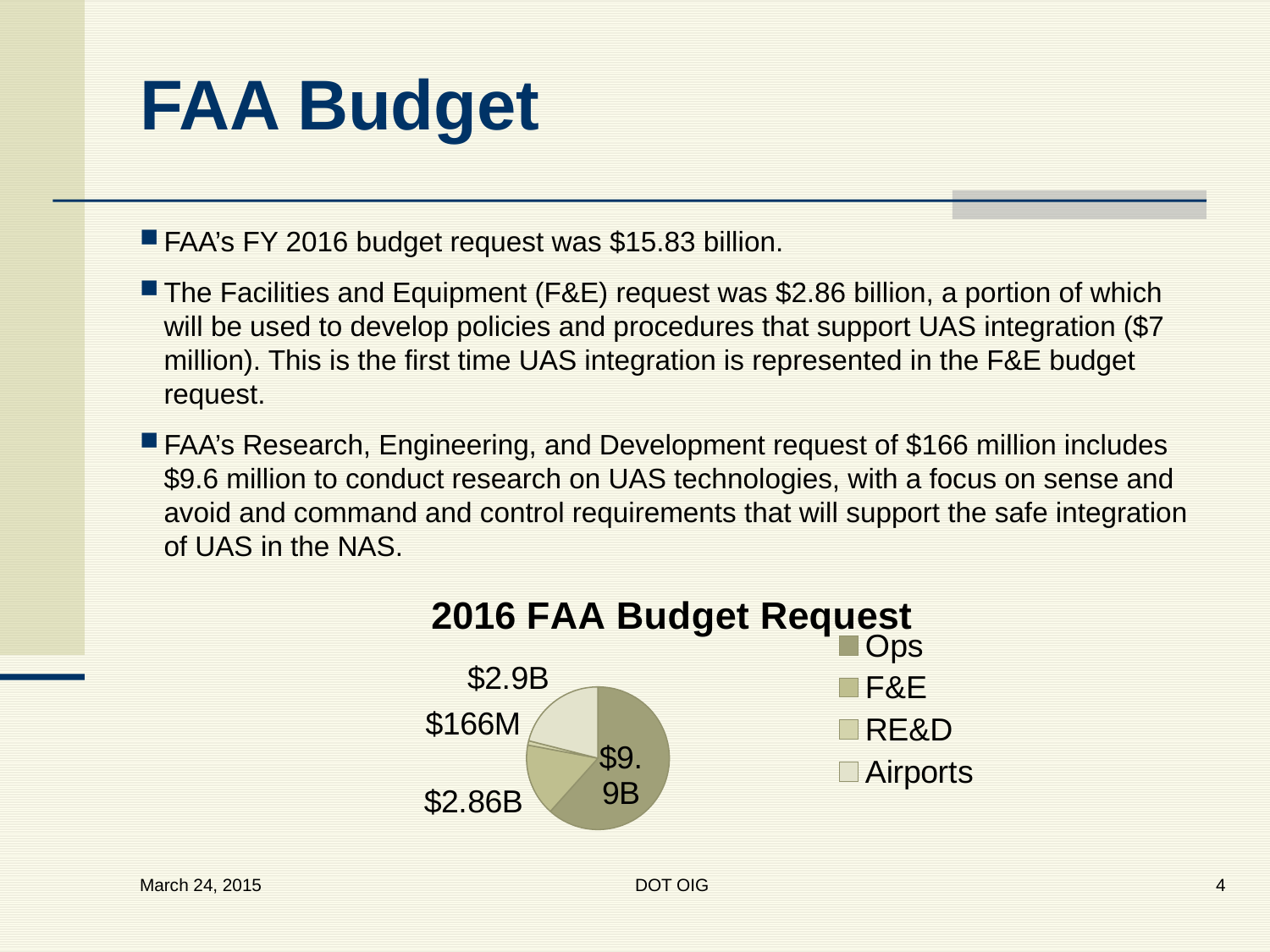
Which is larger in the pie chart, Ops or F&E? Ops What is the value shown for Ops in the pie chart? $9.9B What is the title of the chart on the slide? 2016 FAA Budget Request How many entries does the chart's legend list? 4 Which legend entry is listed first in the pie chart's legend? Ops What is the value shown for Airports in the pie chart? $2.9B What is the value shown for RE&D in the pie chart? $166M What kind of chart is shown on the slide? pie chart How many slices does the pie chart have? 4 Which category has the largest slice of the pie chart? Ops What is the value shown for F&E in the pie chart? $2.86B Which category has the smallest slice of the pie chart? RE&D